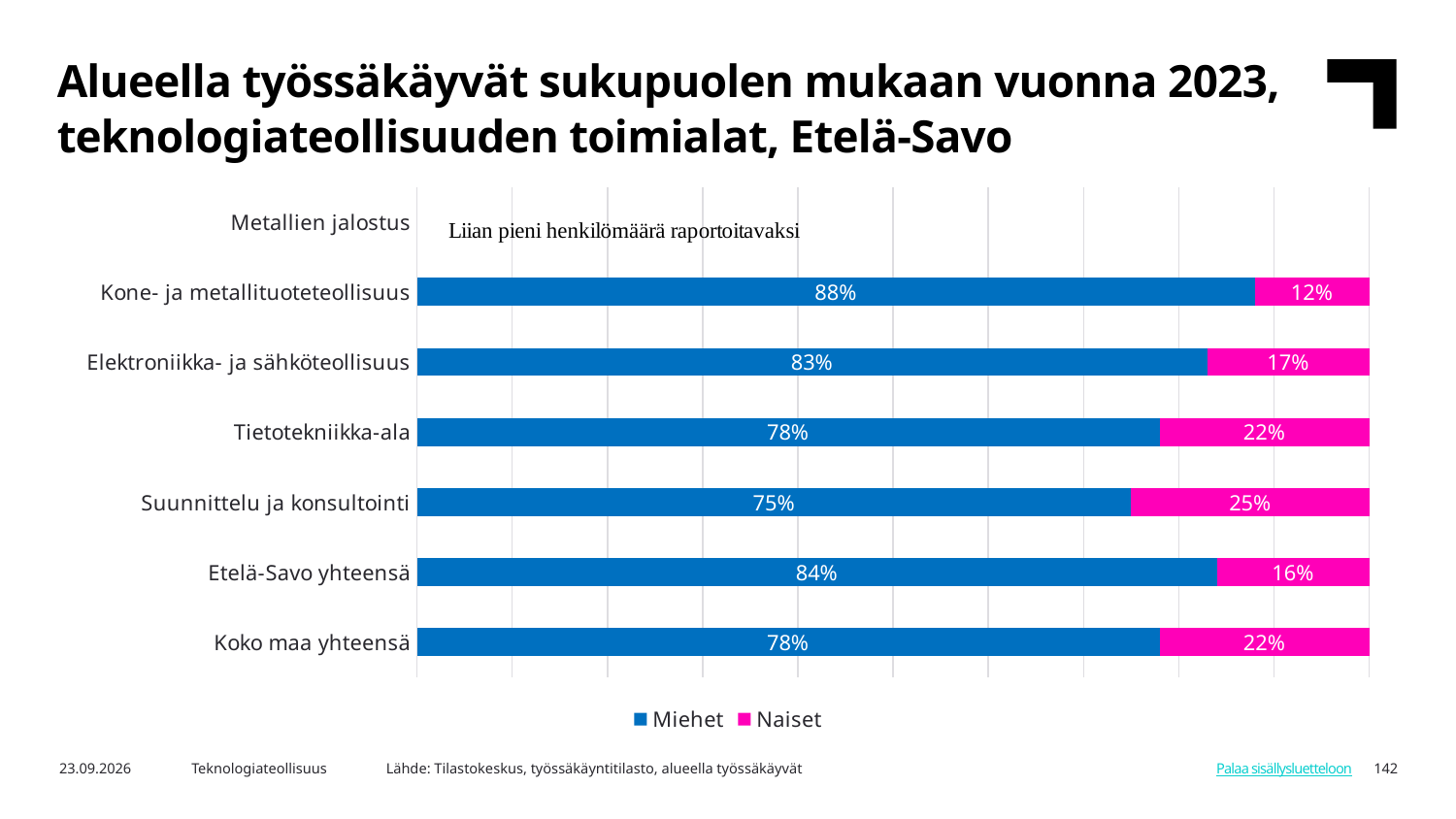
What is the Miehet share for Koko maa yhteensä? 78% What is the Miehet share for Kone- ja metallituoteteollisuus? 88% Which category has the lowest Miehet share? Suunnittelu ja konsultointi Which category has the highest Miehet share? Kone- ja metallituoteteollisuus What is the Naiset share for Etelä-Savo yhteensä? 16% Which has a larger Naiset share, Elektroniikka- ja sähköteollisuus or Tietotekniikka-ala? Tietotekniikka-ala What is the difference between the Naiset share for Suunnittelu ja konsultointi and for Kone- ja metallituoteteollisuus? 13 percentage points How many series does the legend list? 2 What is the Naiset share for Suunnittelu ja konsultointi? 25% What kind of chart is shown on the slide? Stacked bar chart What text is shown in place of the bar for Metallien jalostus? Liian pieni henkilömäärä raportoitavaksi What is the total of the stacked bar for Etelä-Savo yhteensä? 100%